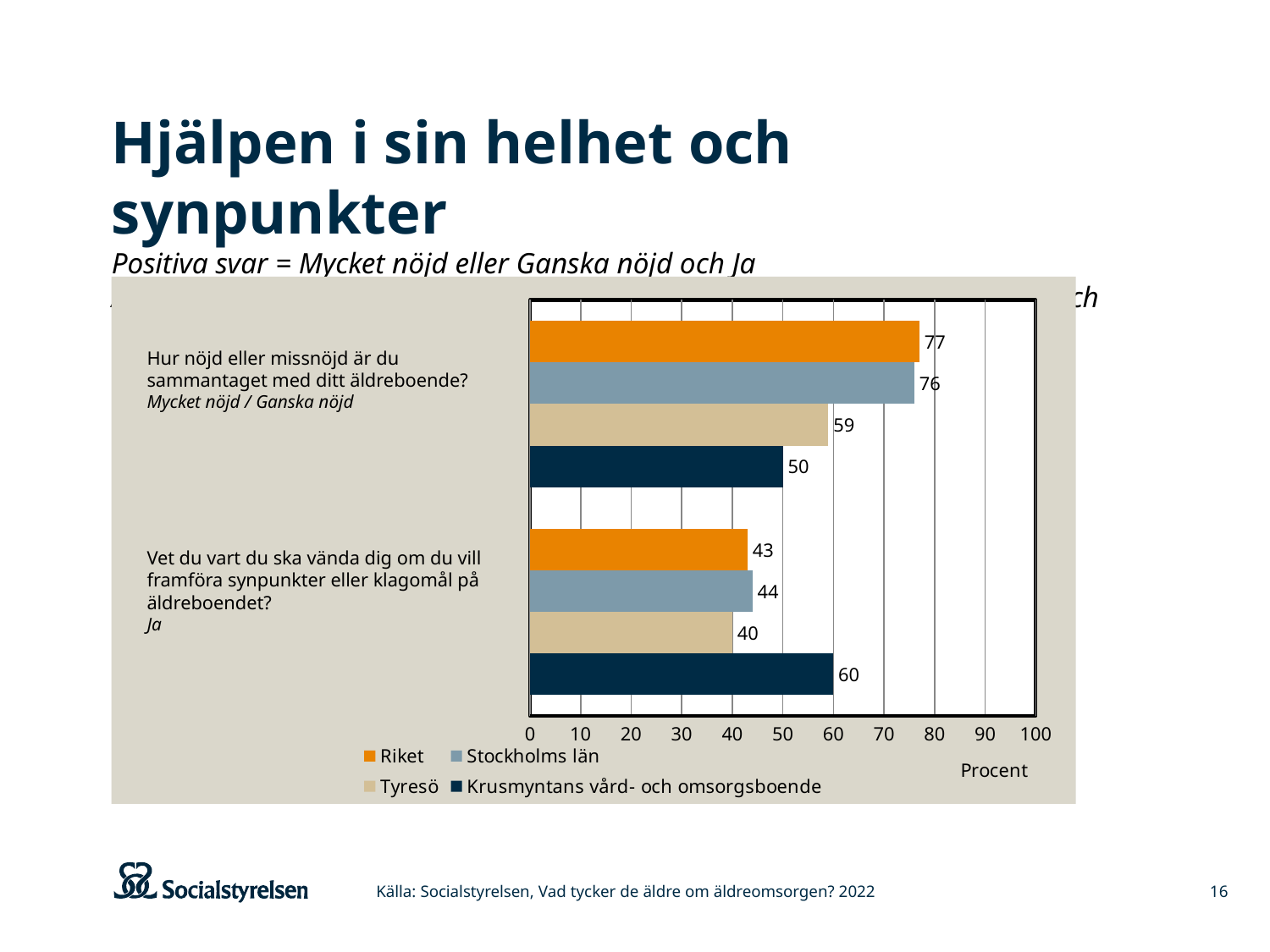
How many question categories are shown on the chart? 2 What is the difference between Krusmyntans vård- och omsorgsboende and Tyresö on the question 'Vet du vart du ska vända dig om du vill framföra synpunkter eller klagomål på äldreboendet?'? 20 Which series has the highest value on the question 'Vet du vart du ska vända dig om du vill framföra synpunkter eller klagomål på äldreboendet?'? Krusmyntans vård- och omsorgsboende On the question 'Vet du vart du ska vända dig om du vill framföra synpunkter eller klagomål på äldreboendet?', which is larger: Riket or Krusmyntans vård- och omsorgsboende? Krusmyntans vård- och omsorgsboende What is the value for Tyresö on the question 'Hur nöjd eller missnöjd är du sammantaget med ditt äldreboende?'? 59 What is the value for Krusmyntans vård- och omsorgsboende on the question 'Vet du vart du ska vända dig om du vill framföra synpunkter eller klagomål på äldreboendet?'? 60 Which series has the lowest value on the question 'Hur nöjd eller missnöjd är du sammantaget med ditt äldreboende?'? Krusmyntans vård- och omsorgsboende What is the label of the x axis? Procent What is the difference between Riket and Krusmyntans vård- och omsorgsboende on the question 'Hur nöjd eller missnöjd är du sammantaget med ditt äldreboende?'? 27 What is the value for Riket on the question 'Hur nöjd eller missnöjd är du sammantaget med ditt äldreboende?'? 77 How many series does the legend list? 4 What kind of chart is shown on the slide? Bar chart